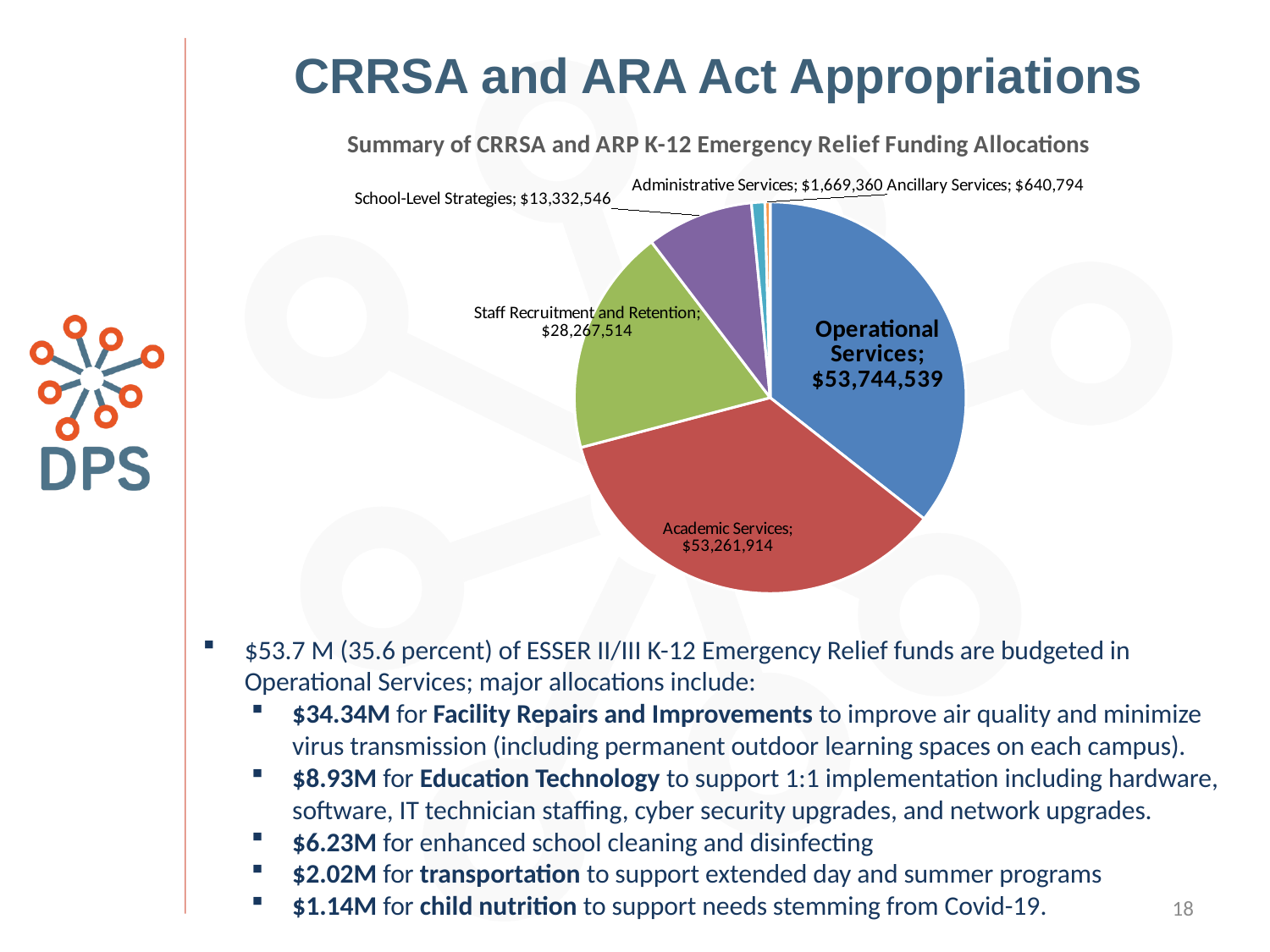
What kind of chart is shown on the slide? Pie chart What is the value for Operational Services in the pie chart? $53,744,539 What is the difference between the Staff Recruitment and Retention allocation and the School-Level Strategies allocation? $14,934,968 What is the value for Staff Recruitment and Retention in the pie chart? $28,267,514 What is the title of the chart? Summary of CRRSA and ARP K-12 Emergency Relief Funding Allocations What is the value for Academic Services in the pie chart? $53,261,914 How many categories are shown in the pie chart? 6 What is the value for Ancillary Services in the pie chart? $640,794 Which category has the largest allocation in the pie chart? Operational Services Which category has the smallest allocation in the pie chart? Ancillary Services What is the value for School-Level Strategies in the pie chart? $13,332,546 Which is larger, the allocation for Administrative Services or for Ancillary Services? Administrative Services